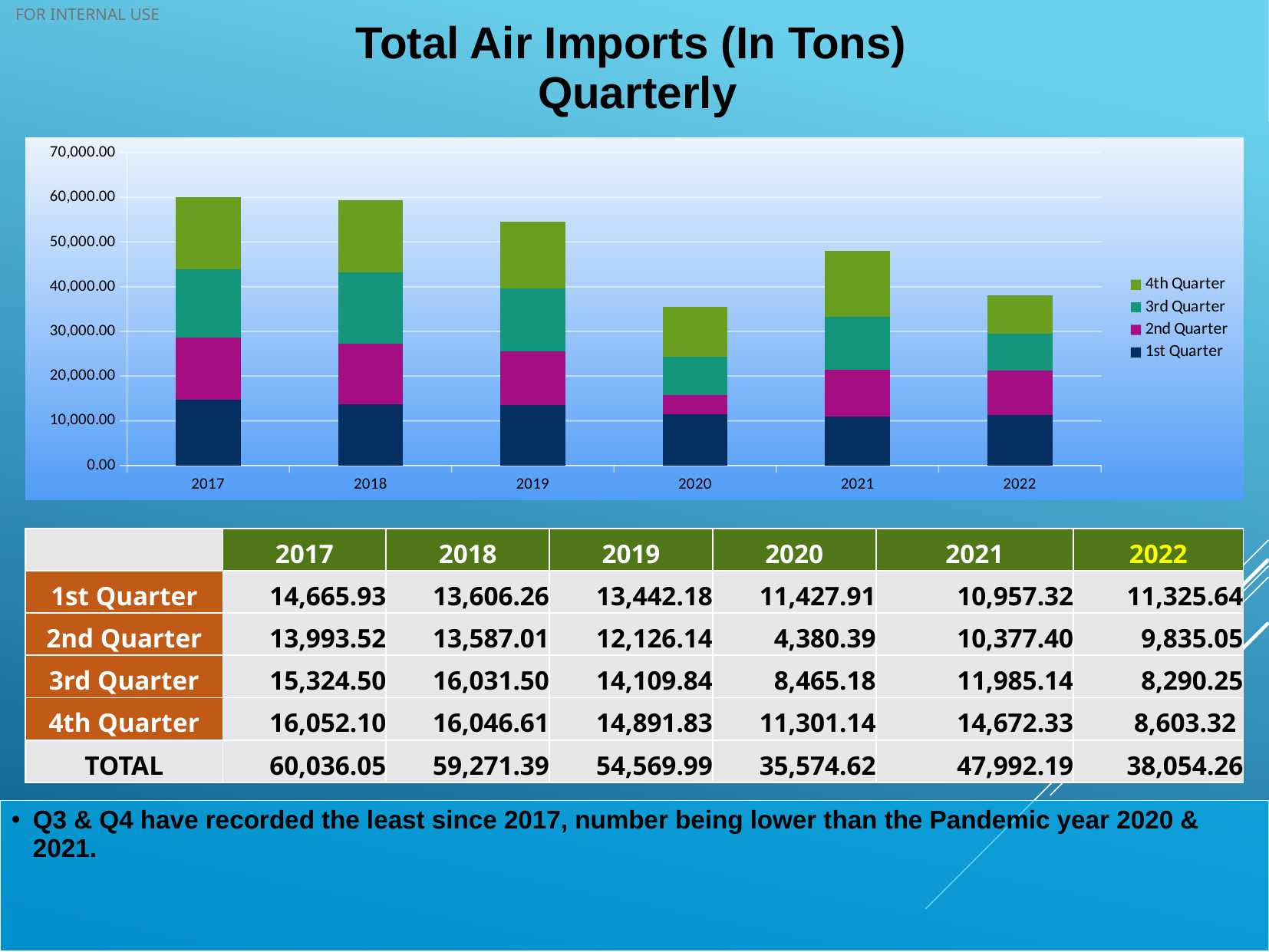
Do the total stacked bar heights rise or fall from 2017 to 2020? fall How many series does the chart legend list? 4 What is the difference between the 4th Quarter values for 2021 and 2022? 6,069.01 Which year has the shortest stacked bar? 2020 What is the 2nd Quarter value for 2020? 4,380.39 What is the 1st Quarter value for 2017? 14,665.93 What kind of chart is shown on the slide? bar chart Which year has the tallest stacked bar? 2017 What is the total of the stacked bar for 2020? 35,574.62 Is the total stacked bar for 2021 greater or less than 40,000.00? greater How many years are shown along the x axis of the chart? 6 Which year has the larger 3rd Quarter value, 2018 or 2019? 2018